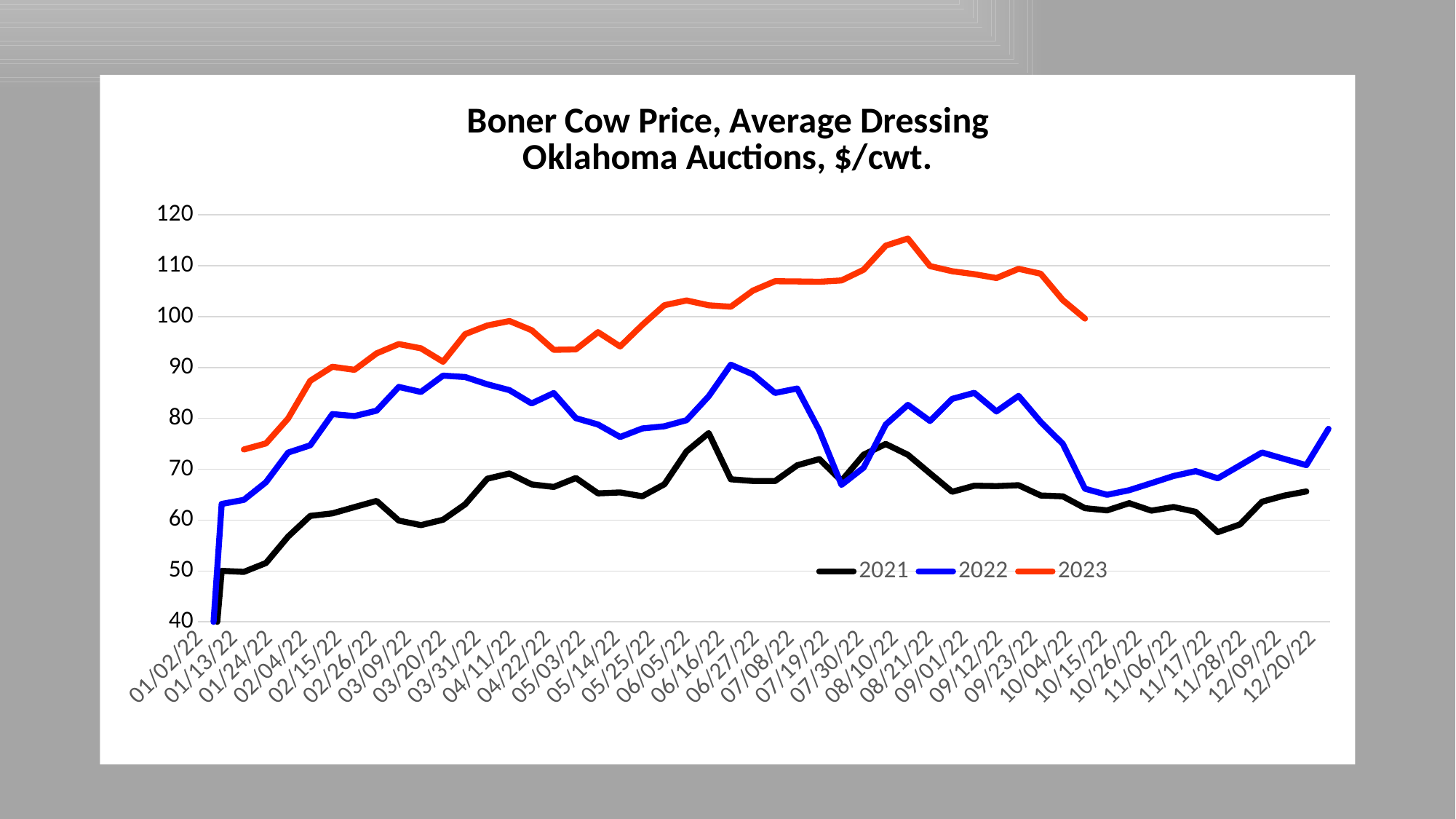
Does the 2023 line rise or fall between 01/13/22 and 08/21/22? rise At 06/16/22, which series has the higher value, 2021 or 2022? 2022 Is the 2021 value at 01/13/22 greater or less than 60? less What are the series names listed in the legend? 2021, 2022, 2023 Is the 2022 value at 10/15/22 greater or less than 70? less How many series does the legend list? 3 Which series has the highest values across the chart? 2023 What kind of chart is shown on the slide? line chart What is the title of the chart? Boner Cow Price, Average Dressing Oklahoma Auctions, $/cwt. Does the 2023 line rise or fall between 08/21/22 and 10/15/22? fall Is the 2022 value at 03/20/22 greater or less than 80? greater